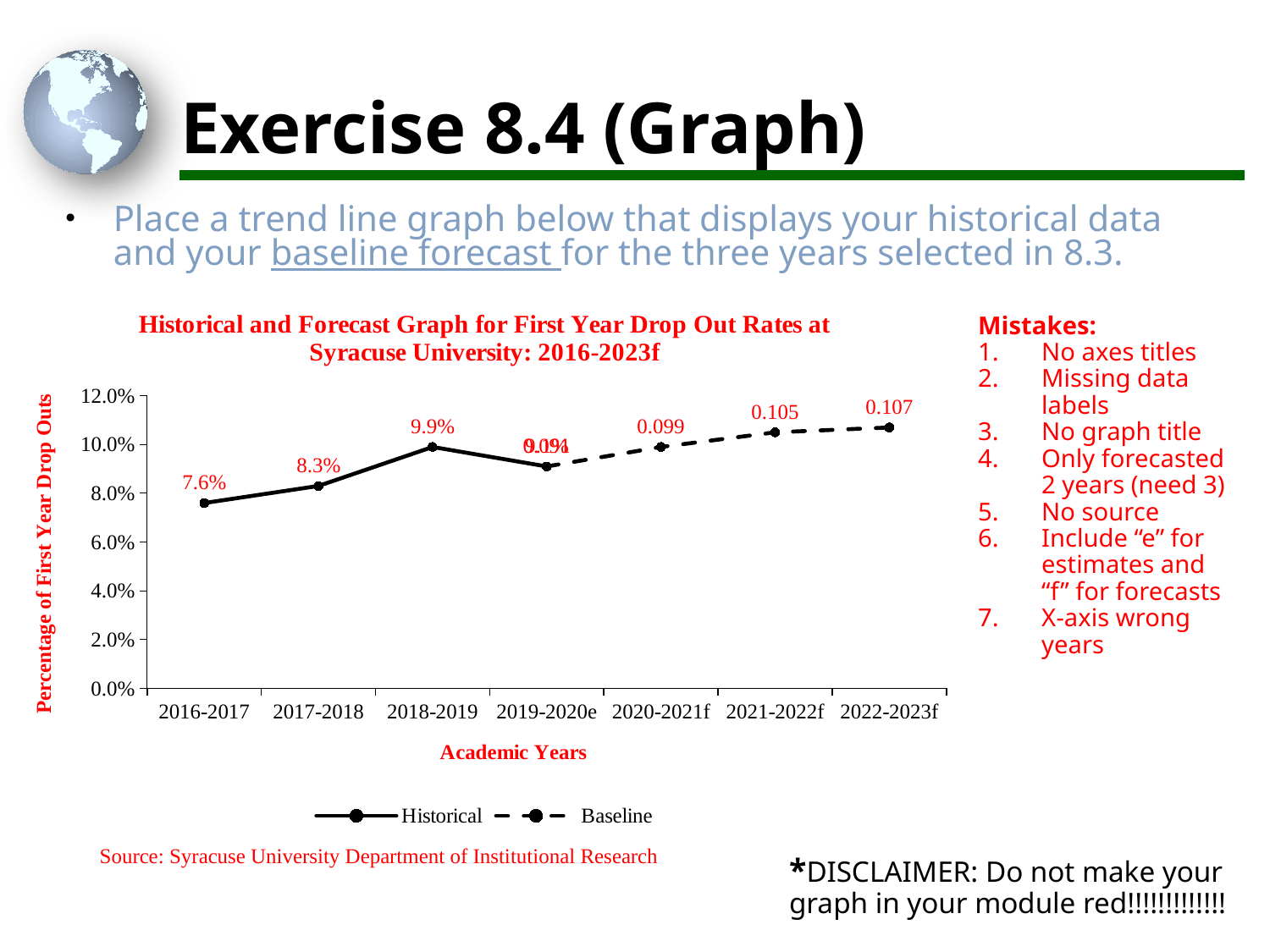
How many series does the legend list? 2 What is the difference between the drop out rates for 2018-2019 and 2017-2018? 1.6% What is the first year drop out rate for 2016-2017? 7.6% What is the baseline forecast value labelled for 2020-2021f? 0.099 What is the baseline forecast value labelled for 2022-2023f? 0.107 What is the first year drop out rate for 2018-2019? 9.9% Which academic year has the highest value on the chart? 2022-2023f Which is larger, the drop out rate for 2017-2018 or for 2016-2017? 2017-2018 What kind of chart is shown on the slide? Line chart Which academic year has the lowest first year drop out rate on the chart? 2016-2017 How many academic years are shown on the x axis? 7 Is the value for 2019-2020e greater or less than 8.0%? greater